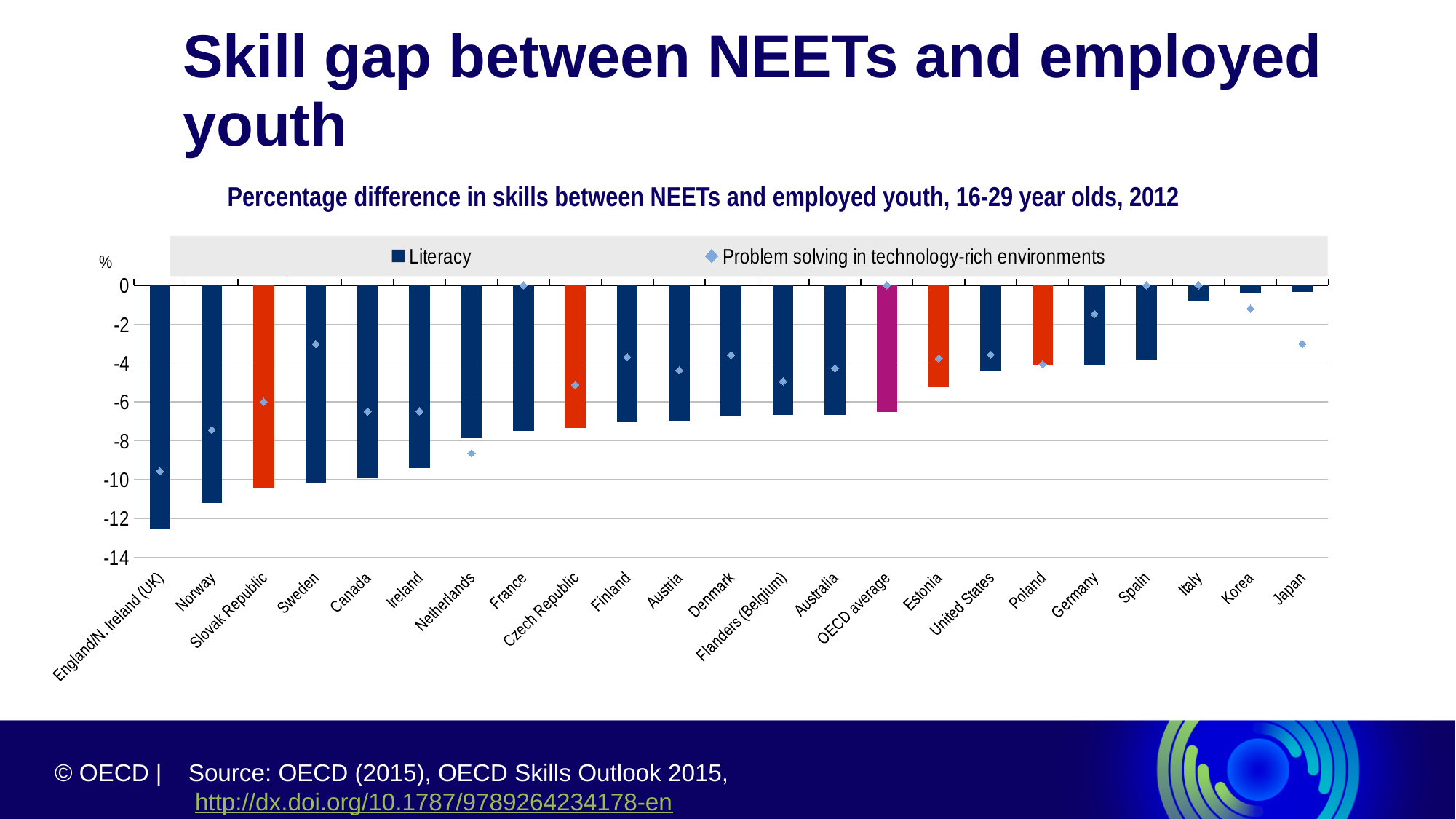
How many countries/categories are shown on the x axis? 23 Is the Literacy value for England/N. Ireland (UK) greater or less than -12? less What are the two series named in the legend? Literacy; Problem solving in technology-rich environments Is the Literacy value for Norway greater or less than -12? greater Which category has the lowest (most negative) Literacy value? England/N. Ireland (UK) Is the Problem solving in technology-rich environments value for the Netherlands greater or less than -8? less Which has the lower (more negative) Literacy value, Norway or Sweden? Norway Do the Literacy values rise or fall moving from left to right along the x axis? rise How many series does the legend list? 2 What kind of chart is shown on the slide? bar chart